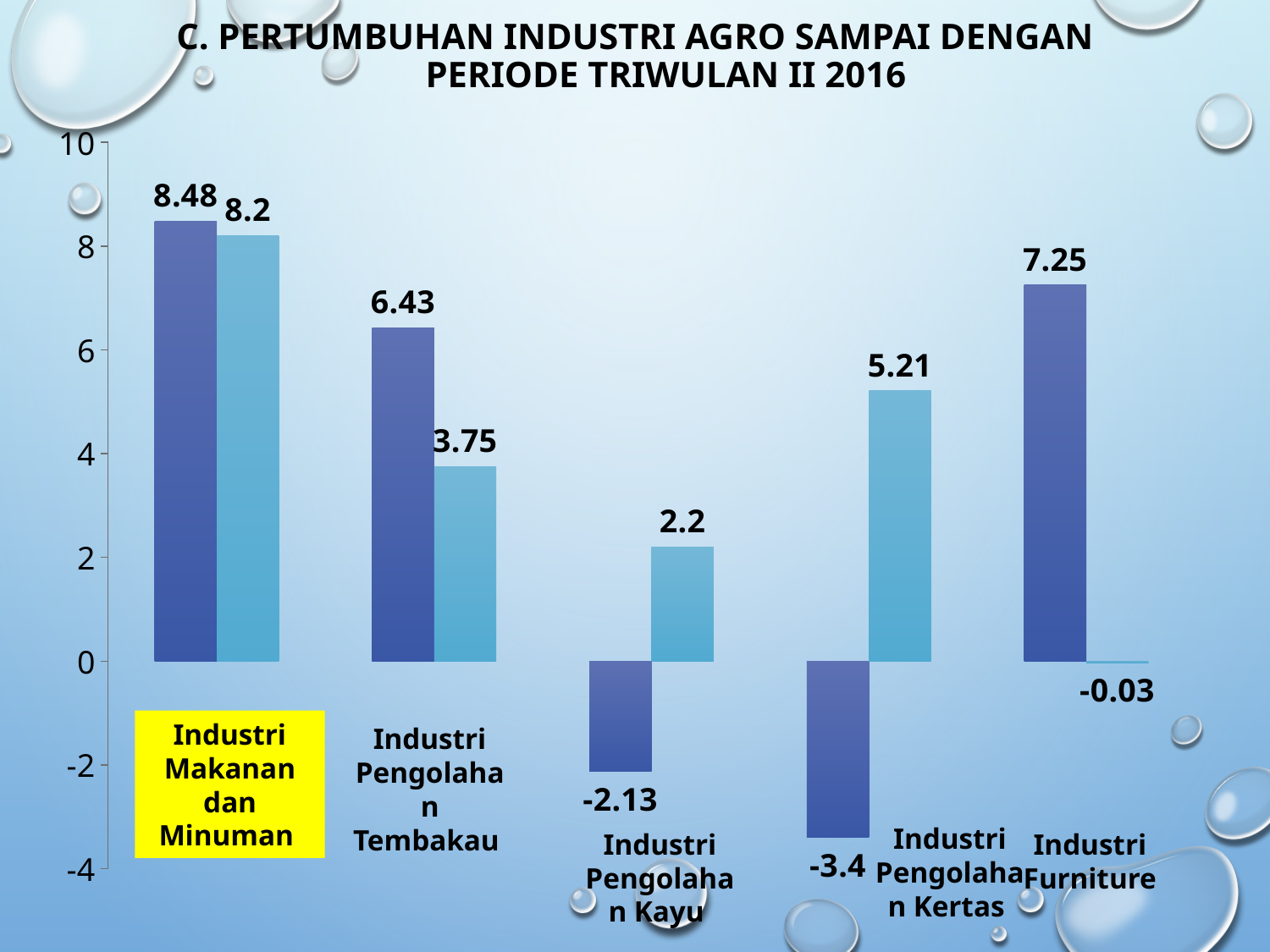
What is the value of the light blue bar for Industri Pengolahan Tembakau? 3.75 Which category has the lowest dark blue bar? Industri Pengolahan Kertas What is the value of the dark blue bar for Industri Makanan dan Minuman? 8.48 What is the value of the light blue bar for Industri Furniture? -0.03 Which category has the lowest light blue bar? Industri Furniture For Industri Pengolahan Kertas, which bar is larger, the dark blue or the light blue? light blue What type of chart is shown on the slide? bar chart What is the value of the dark blue bar for Industri Pengolahan Kayu? -2.13 How many industry categories are shown on the x axis? 5 What is the title of the chart? C. PERTUMBUHAN INDUSTRI AGRO SAMPAI DENGAN PERIODE TRIWULAN II 2016 Which category has the highest dark blue bar? Industri Makanan dan Minuman What is the difference between the dark blue and light blue bars for Industri Pengolahan Tembakau? 2.68